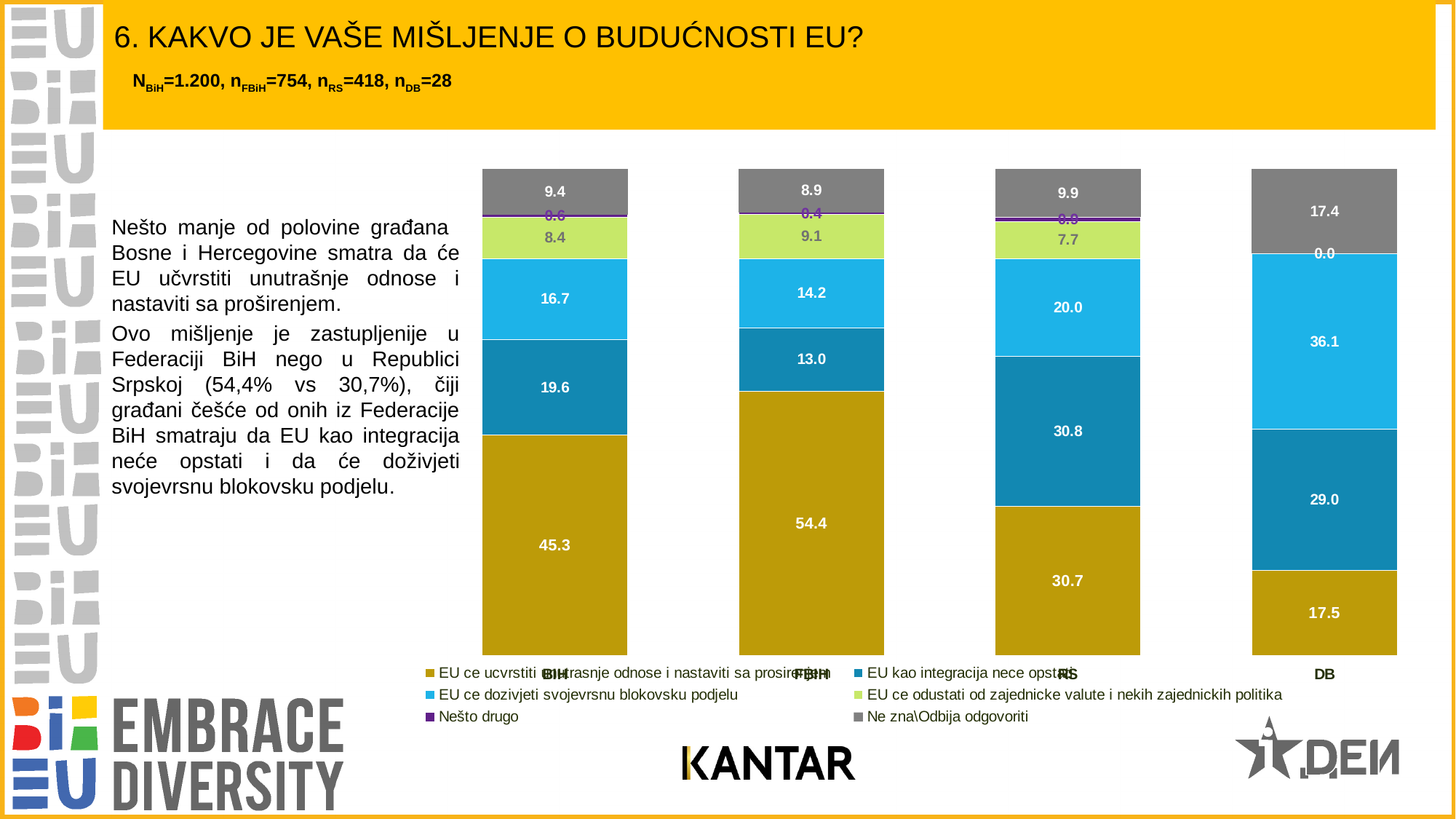
What is the value for DB in the series "EU ce dozivjeti svojevrsnu blokovsku podjelu"? 36.1 What is the value for FBiH in the series "EU ce ucvrstiti unutrasnje odnose i nastaviti sa prosirenjem"? 54.4 Which category has the highest value in the series "EU ce ucvrstiti unutrasnje odnose i nastaviti sa prosirenjem"? FBiH What is the value for DB in the series "Ne zna\Odbija odgovoriti"? 17.4 What is the value for BiH in the series "EU ce ucvrstiti unutrasnje odnose i nastaviti sa prosirenjem"? 45.3 Which is larger for the series "EU kao integracija nece opstati": BiH or FBiH? BiH How many series does the legend list? 6 What is the value for RS in the series "EU kao integracija nece opstati"? 30.8 What kind of chart is shown on the slide? Stacked bar chart How many categories are shown on the x axis of the chart? 4 What is the difference between FBiH and RS in the series "EU ce ucvrstiti unutrasnje odnose i nastaviti sa prosirenjem"? 23.7 Which category has the lowest value in the series "EU ce ucvrstiti unutrasnje odnose i nastaviti sa prosirenjem"? DB